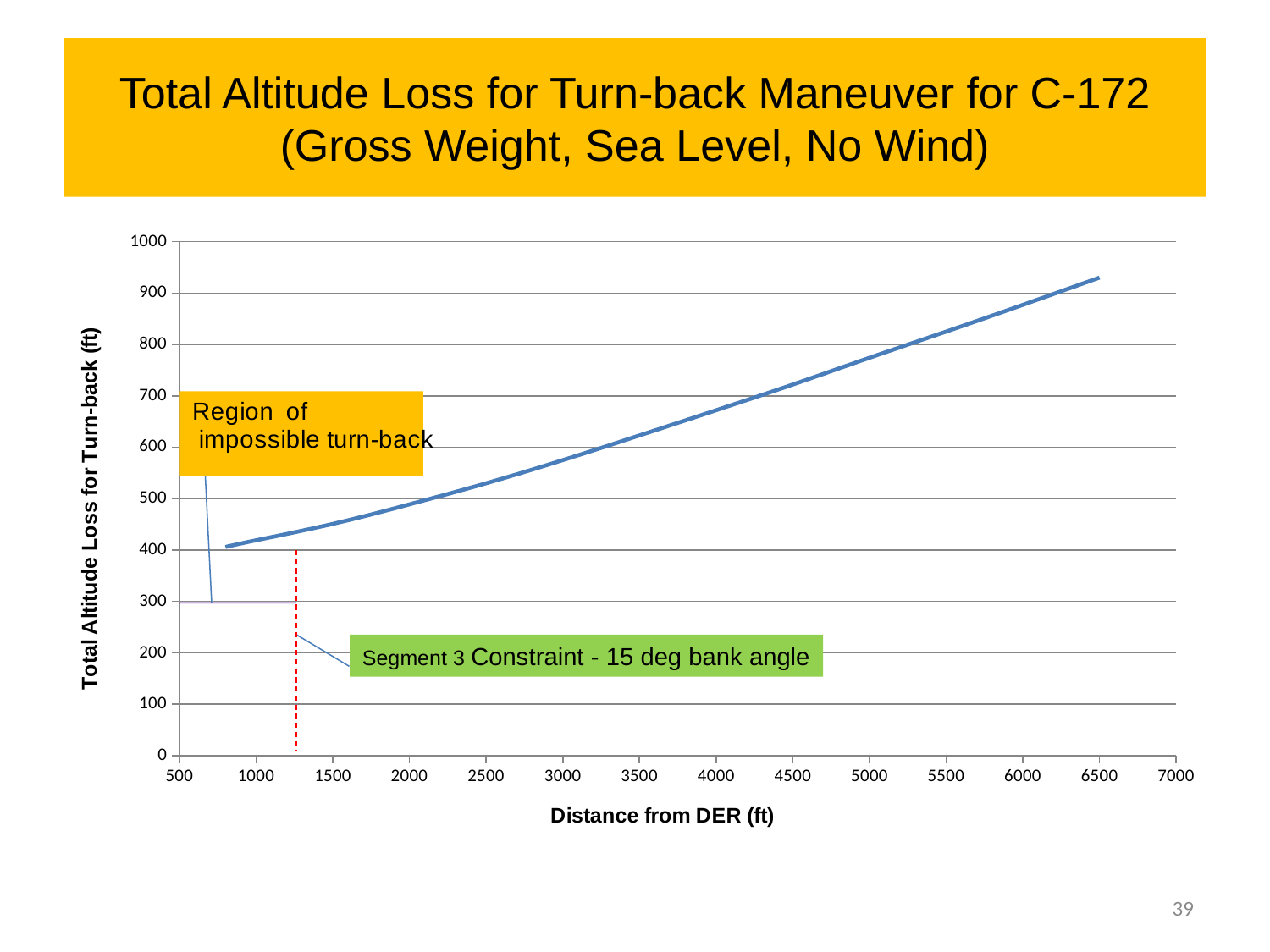
What kind of chart is shown on the slide? line chart Is the total altitude loss at a distance of 6500 ft from DER greater or less than 900? greater Is the total altitude loss at a distance of 3000 ft from DER greater or less than 500? greater What is the title of the x axis of the chart? Distance from DER (ft) Does the total altitude loss for turn-back rise or fall as the distance from DER increases? rise What text is shown in the green annotation box on the chart? Segment 3 Constraint - 15 deg bank angle Is the total altitude loss at a distance of 4000 ft from DER greater or less than 600? greater